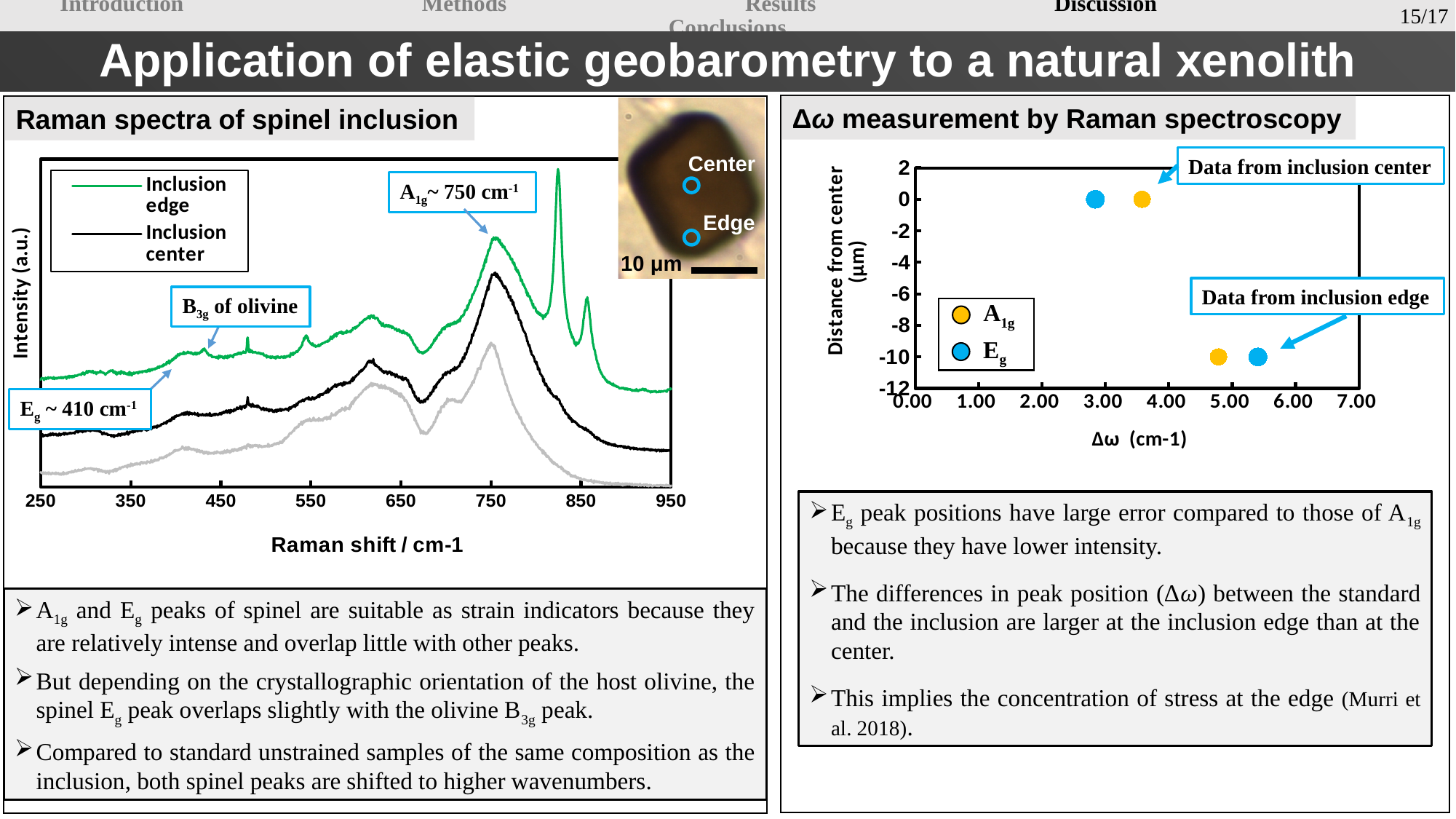
In the 'Raman spectra of spinel inclusion' chart, which series is drawn in green? Inclusion edge In the 'Δω measurement by Raman spectroscopy' chart, is the Δω value of the Eg point at the inclusion edge greater or less than 5.00? greater How many series does the legend of the 'Δω measurement by Raman spectroscopy' chart list? 2 How many series does the legend of the 'Raman spectra of spinel inclusion' chart list? 2 How many data points are plotted in the 'Δω measurement by Raman spectroscopy' chart? 4 In the 'Δω measurement by Raman spectroscopy' chart, what is the distance from center (μm) for the data from the inclusion center? 0 In the 'Δω measurement by Raman spectroscopy' chart, which series has the larger Δω at the inclusion center, A1g or Eg? A1g In the 'Δω measurement by Raman spectroscopy' chart, what is the distance from center (μm) for the data from the inclusion edge? -10 What kind of chart is the 'Raman spectra of spinel inclusion' chart on the left? line chart What kind of chart is the 'Δω measurement by Raman spectroscopy' chart on the right? scatter chart In the 'Δω measurement by Raman spectroscopy' chart, which series has the larger Δω at the inclusion edge, A1g or Eg? Eg